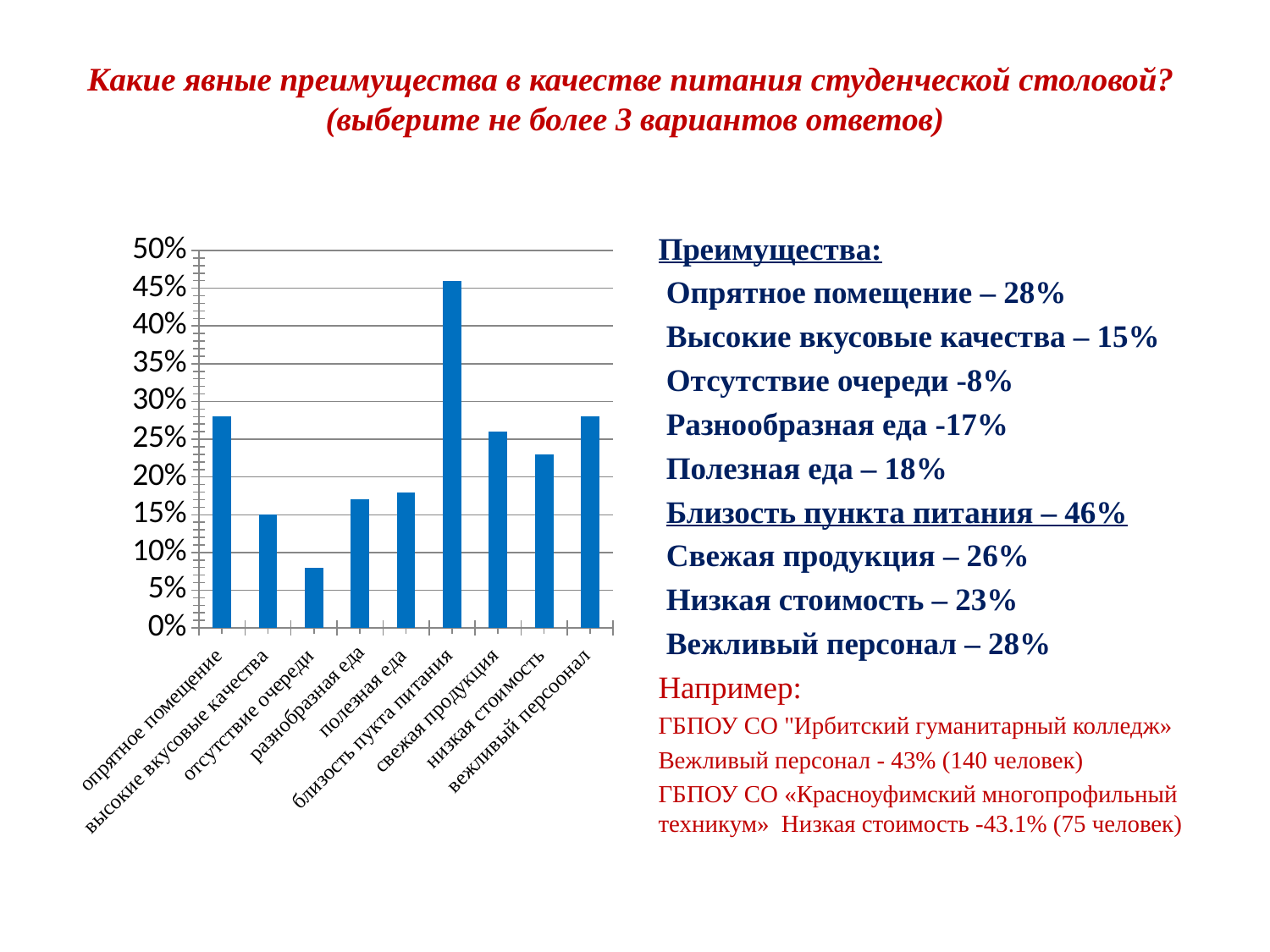
What is the difference between the values for близость пункта питания and отсутствие очереди? 38 percentage points What is the value for отсутствие очереди? 8% Which category has the highest value on the chart? близость пункта питания What is the value for низкая стоимость? 23% Is the value for высокие вкусовые качества greater or less than 20%? less Which is larger, the value for свежая продукция or the value for низкая стоимость? свежая продукция Is the value for близость пункта питания greater or less than 40%? greater Which category has the lowest value on the chart? отсутствие очереди What kind of chart is shown on the slide? bar chart What is the value for близость пункта питания? 46% What is the highest tick value shown on the vertical axis? 50% How many categories are plotted on the chart? 9